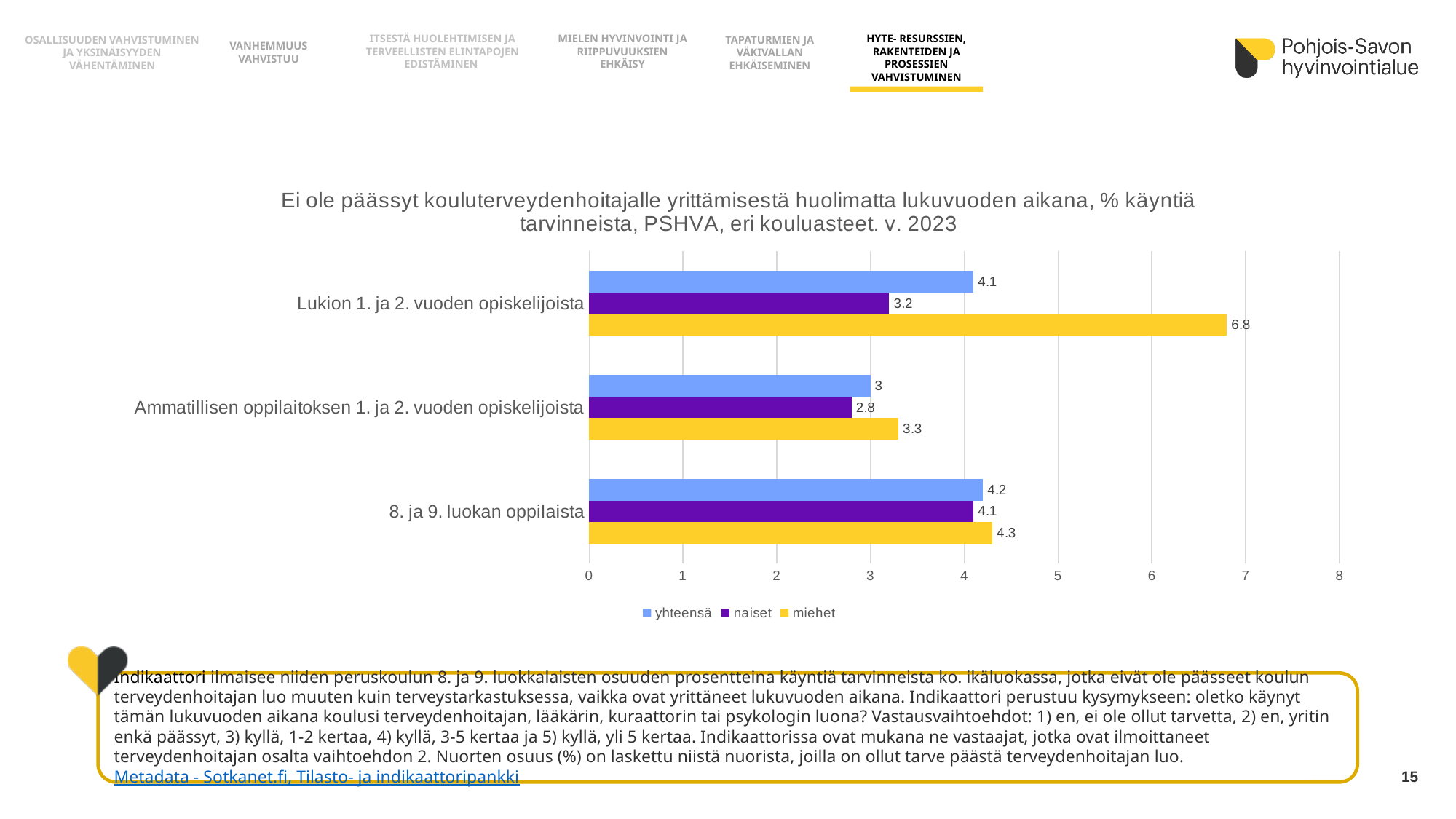
How many categories are shown on the chart? 3 Which series is shown in yellow in the legend? miehet Which is larger for 8. ja 9. luokan oppilaista: the miehet value or the naiset value? miehet What is the difference between the miehet and naiset values for Lukion 1. ja 2. vuoden opiskelijoista? 3.6 What is the value for miehet among Lukion 1. ja 2. vuoden opiskelijoista? 6.8 How many series does the legend list? 3 Which category has the highest value for miehet? Lukion 1. ja 2. vuoden opiskelijoista Is the miehet value for Lukion 1. ja 2. vuoden opiskelijoista greater or less than 6? greater What is the value for yhteensä among 8. ja 9. luokan oppilaista? 4.2 What is the value for naiset among Ammatillisen oppilaitoksen 1. ja 2. vuoden opiskelijoista? 2.8 What kind of chart is shown on the slide? bar chart Which category has the lowest value for naiset? Ammatillisen oppilaitoksen 1. ja 2. vuoden opiskelijoista